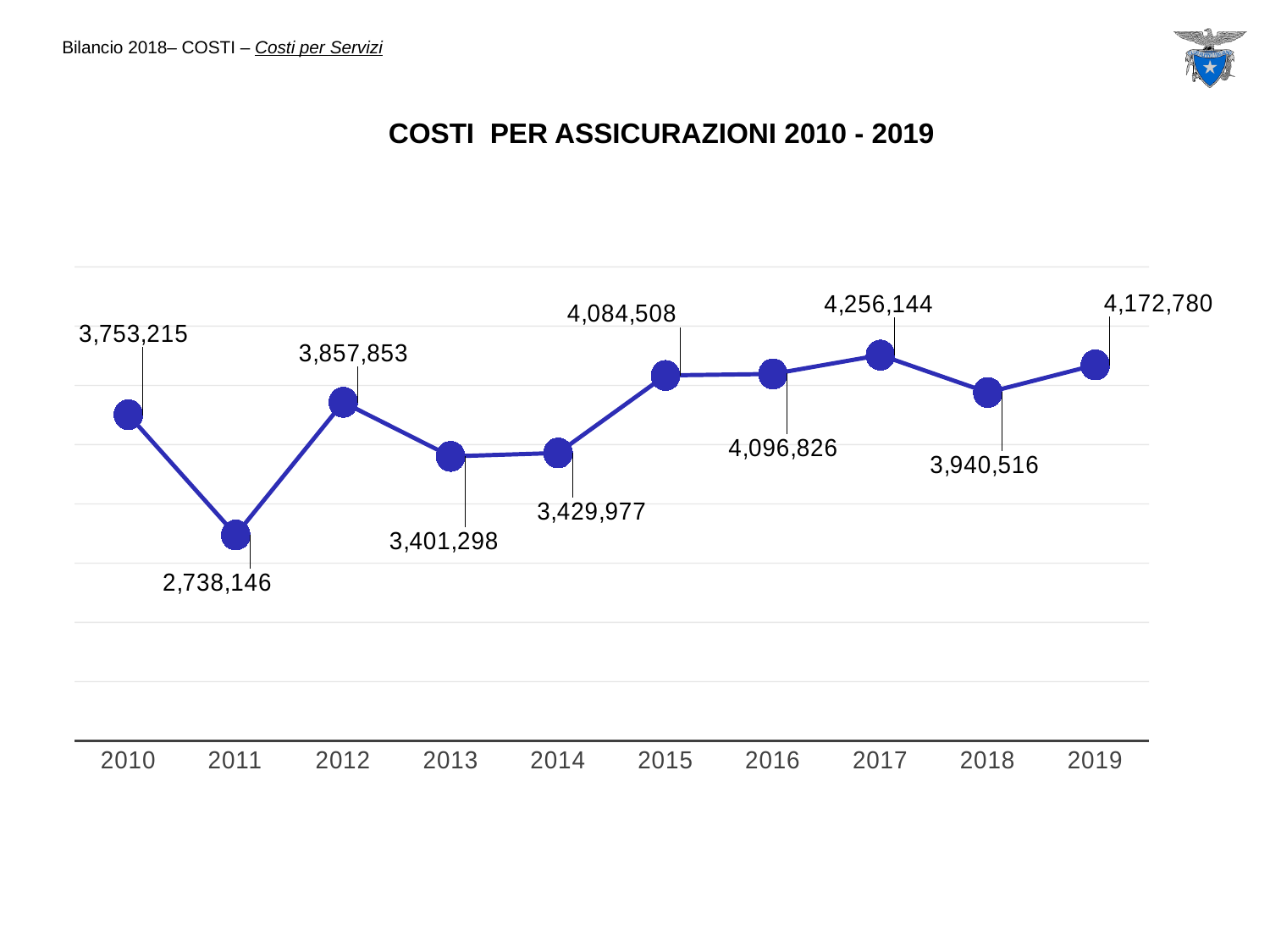
What is the value for 2019? 4,172,780 What is the title of the chart? COSTI PER ASSICURAZIONI 2010 - 2019 Which year has the highest value? 2017 What kind of chart is shown? Line chart What is the difference between the values for 2017 and 2011? 1,517,998 What is the difference between the values for 2019 and 2018? 232,264 Which year has the lowest value? 2011 How many years are plotted on the chart? 10 Which is larger, the value for 2012 or the value for 2013? 2012 What is the value for 2017? 4,256,144 What is the value for 2011? 2,738,146 What is the value for 2013? 3,401,298